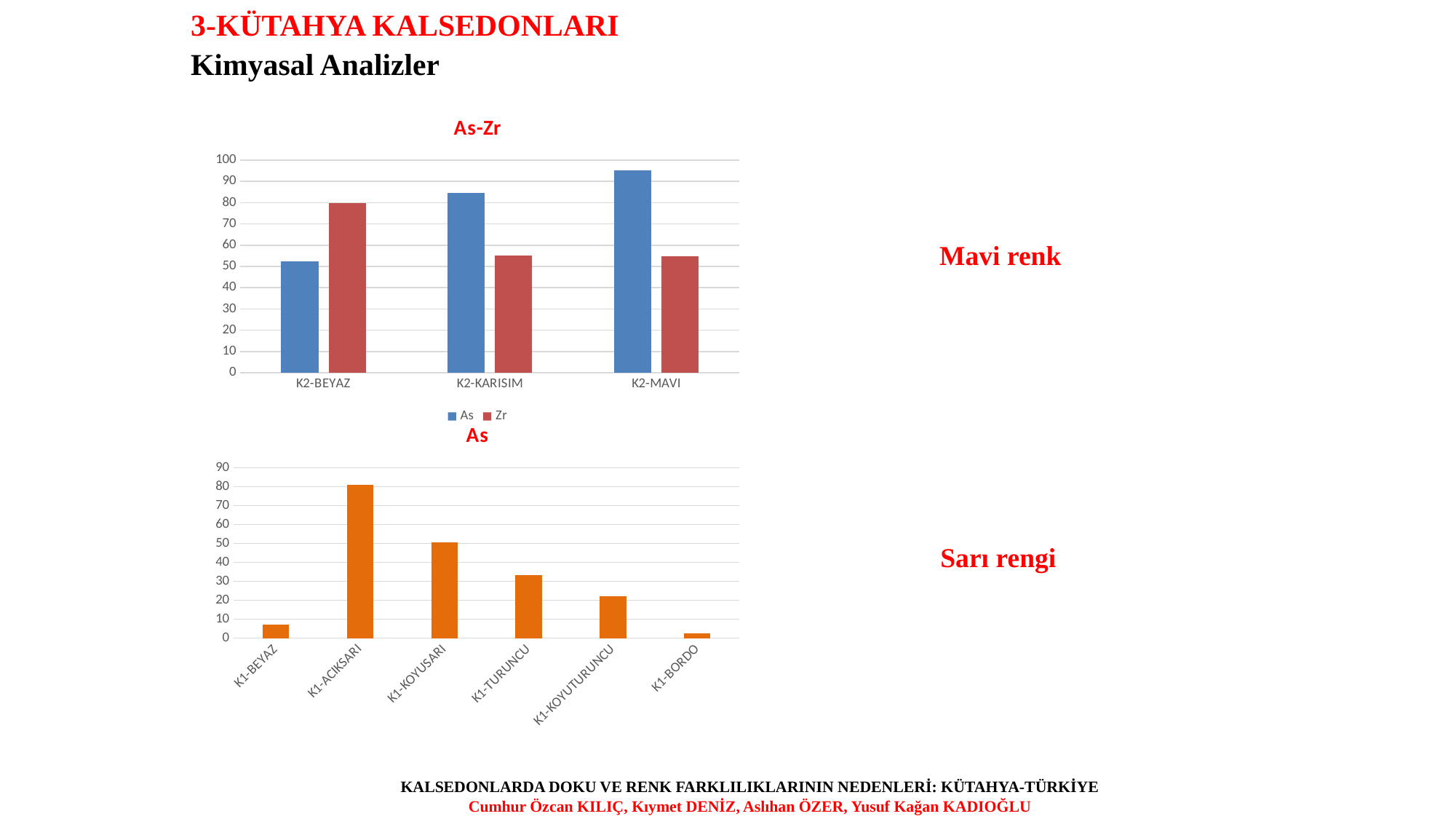
How many series does the legend of the As-Zr chart list? 2 In the As-Zr chart, is the As value for K2-BEYAZ greater or less than 60? less In the As-Zr chart, for K2-KARISIM, which is larger, As or Zr? As What kind of chart is the As chart? bar chart In the As-Zr chart, which category has the highest As value? K2-MAVI In the As chart, is the value for K1-TURUNCU greater or less than 30? greater In the As chart, which category has the highest value? K1-ACIKSARI In the As-Zr chart, is the As value for K2-MAVI greater or less than 90? greater In the As-Zr chart, which category has the highest Zr value? K2-BEYAZ In the As-Zr chart, which category has the lowest As value? K2-BEYAZ In the As chart, which category has the lowest value? K1-BORDO How many categories are shown in the As chart? 6